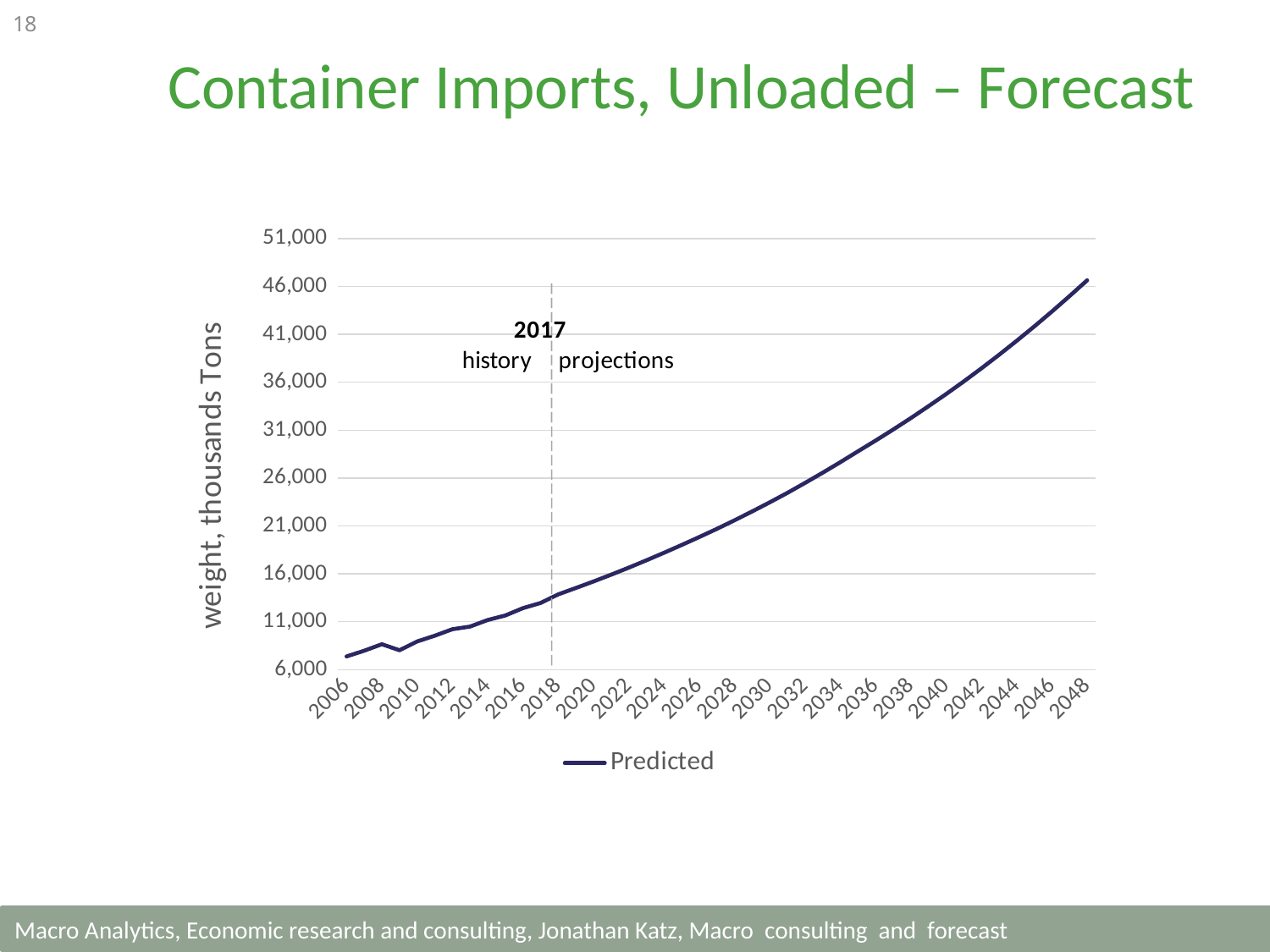
Do the values generally rise or fall from 2006 to 2048? rise Which year has the highest value on the chart? 2048 Is the value for 2030 greater or less than 21,000? greater Is the value for 2006 greater or less than 11,000? less Is the value for 2048 greater or less than 41,000? greater What is the name of the series shown in the legend? Predicted Which year has the lowest value on the chart? 2006 What kind of chart is shown on the slide? line chart How many series does the legend list? 1 What is the label on the vertical axis? weight, thousands Tons